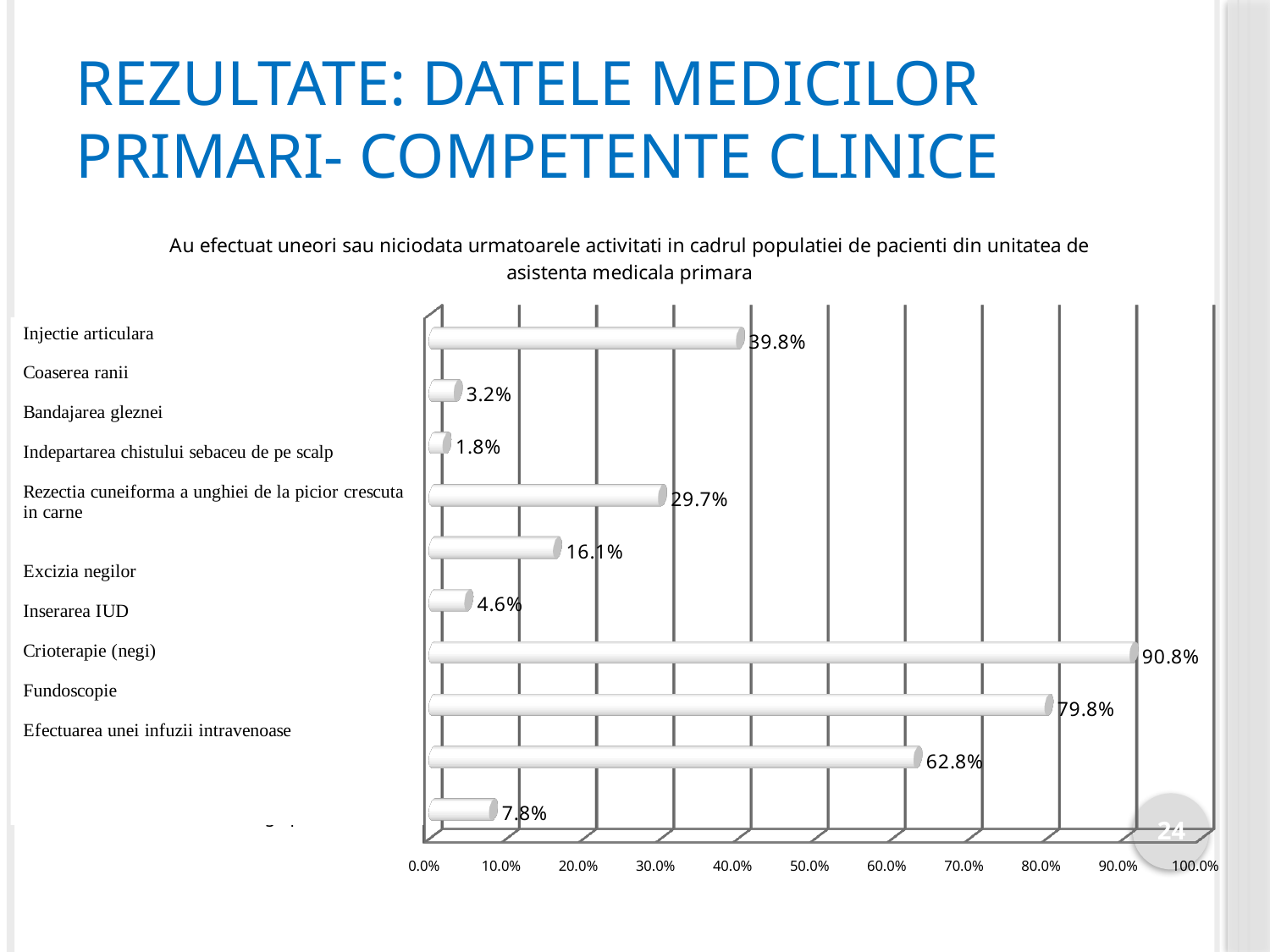
What is the difference between the bars labelled 39.8% and 29.7%? 10.1% What is the difference between the two longest bars, 90.8% and 79.8%? 11.0% What kind of chart is shown on the slide? bar chart What is the value of the shortest bar in the chart? 1.8% What is the maximum value shown on the horizontal axis of the chart? 100.0% What is the value of the longest bar in the chart? 90.8% Which is larger, the bar labelled 29.7% or the bar labelled 16.1%? 29.7% Is the value of the bar labelled 62.8% greater or less than 50.0%? greater What is the value shown on the topmost bar of the chart? 39.8% What is the value shown on the bottom bar of the chart? 7.8% What is the value labelled for Crioterapie (negi)? 79.8% How many bars are plotted in the chart? 10